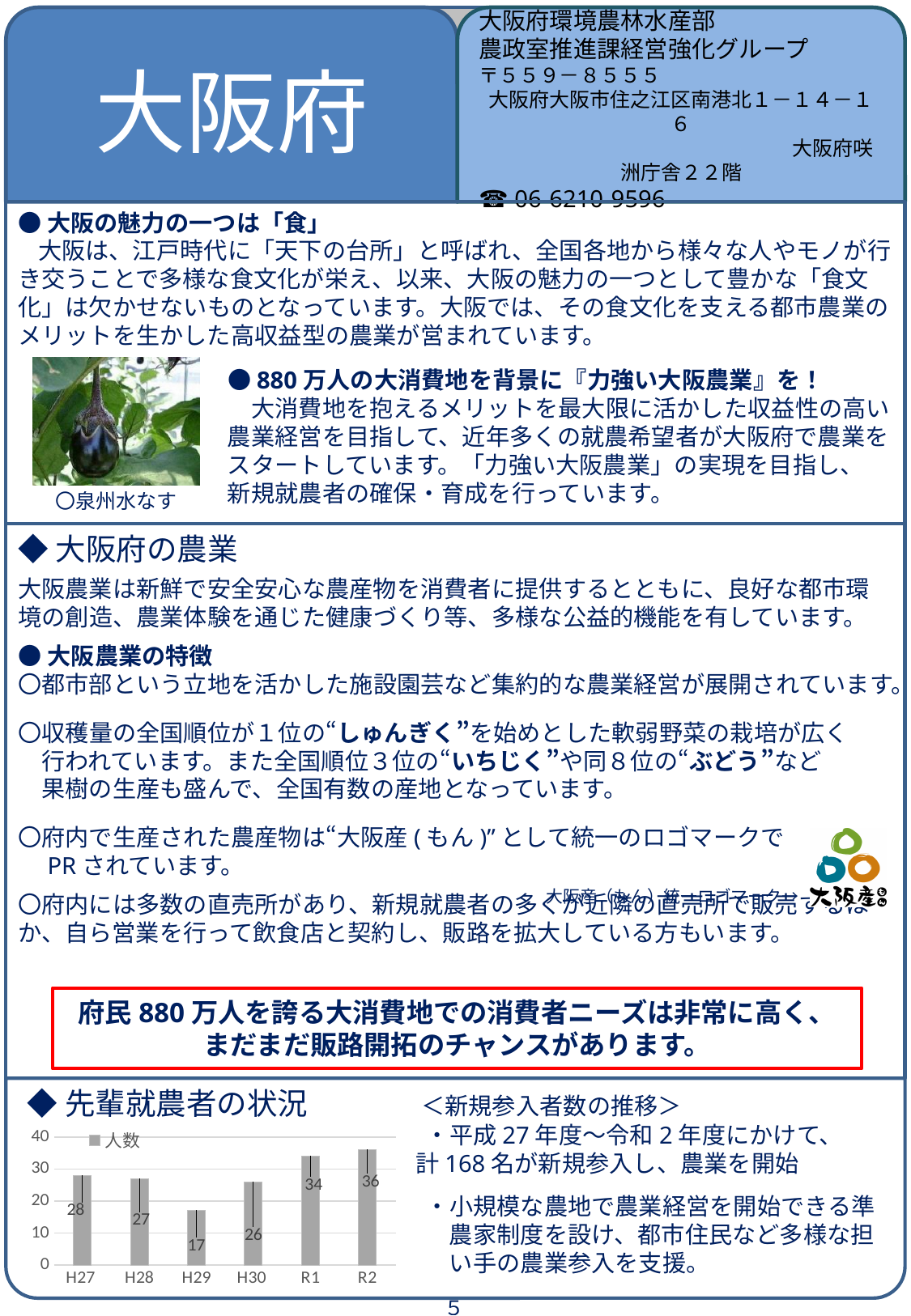
What is the value for H29 in the bar chart? 17 What kind of chart is shown at the bottom of the slide? bar chart How many series does the legend of the bar chart list? 1 What is the value for H27 in the bar chart? 28 What is the value for R1 in the bar chart? 34 How many categories are shown on the x axis of the bar chart? 6 Is the value for R2 in the bar chart greater or less than 30? greater What is the difference between the values for R2 and H29 in the bar chart? 19 What is the legend entry of the bar chart? 人数 Which category has the lowest value in the bar chart? H29 Which category has the highest value in the bar chart? R2 Which is larger in the bar chart, the value for H30 or the value for R1? R1